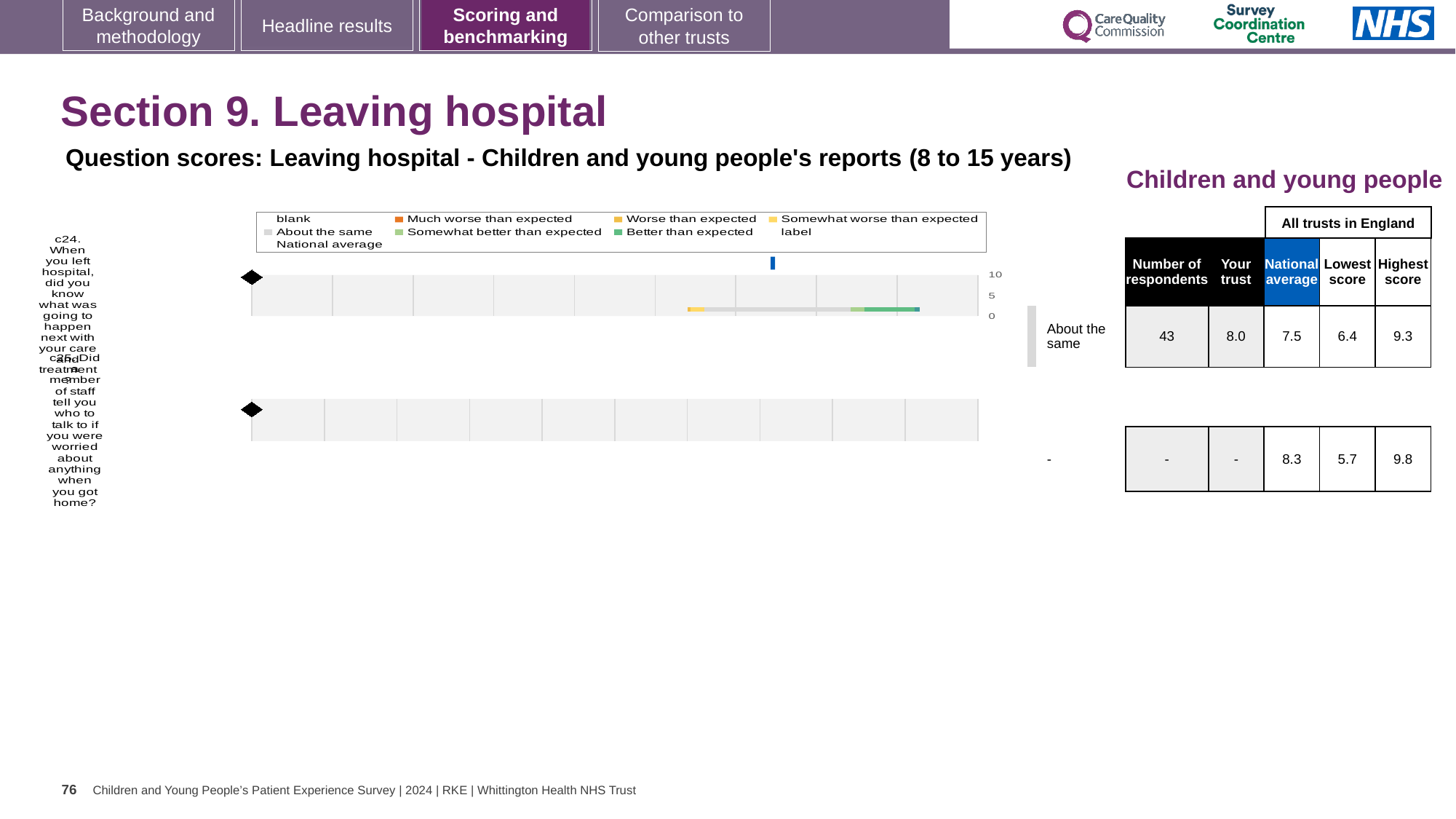
What is the national average score for question c24? 7.5 What is the national average score for question c25 (Did a member of staff tell you who to talk to if you were worried about anything when you got home)? 8.3 What is the lowest score among all trusts in England for question c24? 6.4 What is the highest score among all trusts in England for question c24? 9.3 What is the highest score among all trusts in England for question c25? 9.8 What is the difference between the highest and lowest trust scores for question c24? 2.9 What is the 'Your trust' score for question c24 (When you left hospital, did you know what was going to happen next with your care and treatment)? 8.0 What benchmarking category is shown for question c24? About the same What kind of chart is used to show the question scores on this slide? bar chart How many questions (rows) are plotted in the chart? 2 How many respondents answered question c24? 43 For question c24, which is larger: the trust's score or the national average? Your trust (8.0)